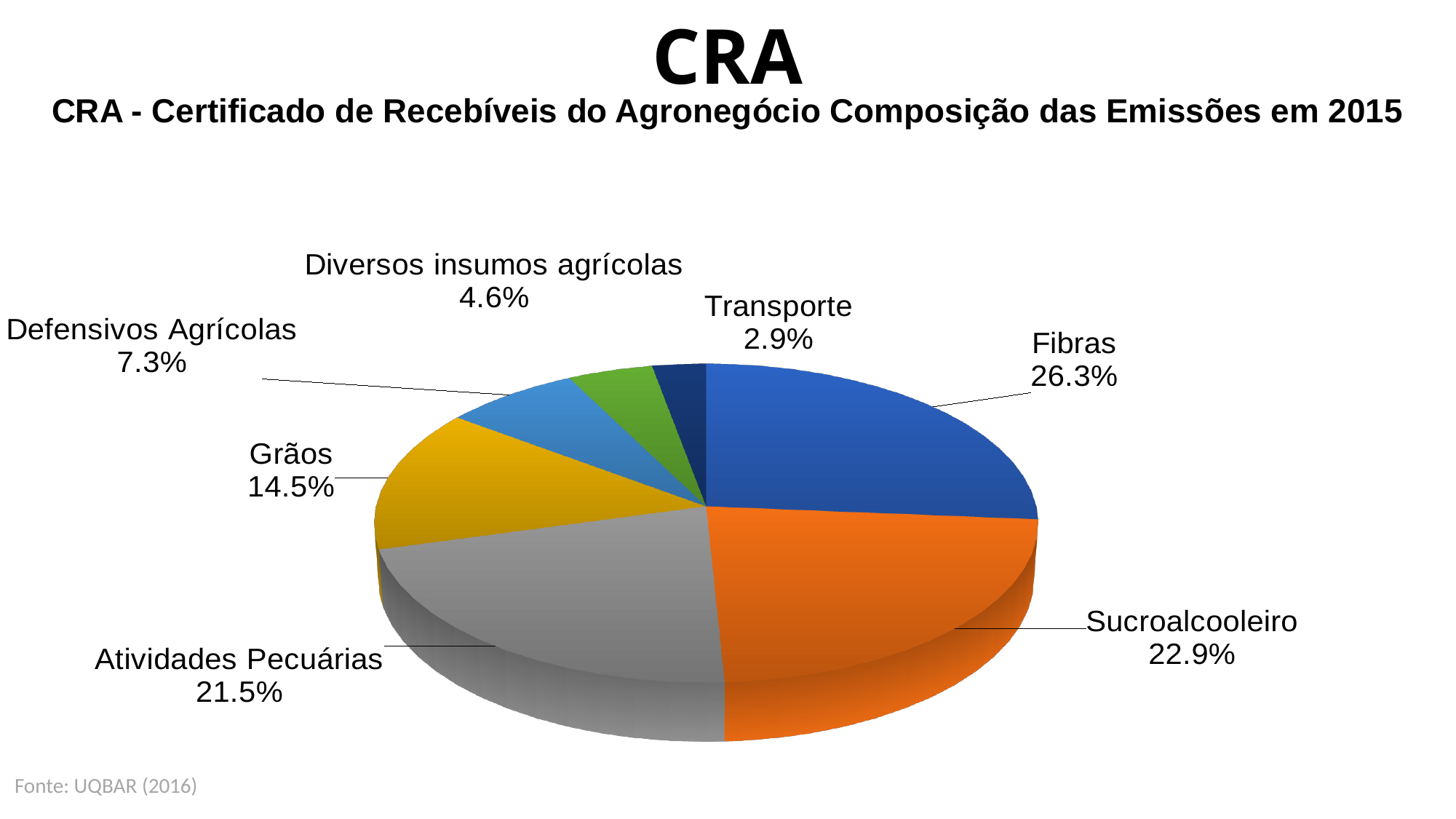
How many categories are shown in the pie chart? 7 What share of CRA emissions in 2015 is Transporte? 2.9% Which is larger, Defensivos Agrícolas or Diversos insumos agrícolas? Defensivos Agrícolas What share of CRA emissions in 2015 is Fibras? 26.3% Which category has the largest share of the pie? Fibras What share of CRA emissions in 2015 is Sucroalcooleiro? 22.9% What is the difference in percentage points between Fibras and Sucroalcooleiro? 3.4 percentage points What kind of chart is shown on the slide? Pie chart What is the source cited for the chart? UQBAR (2016) Which category has the smallest share of the pie? Transporte